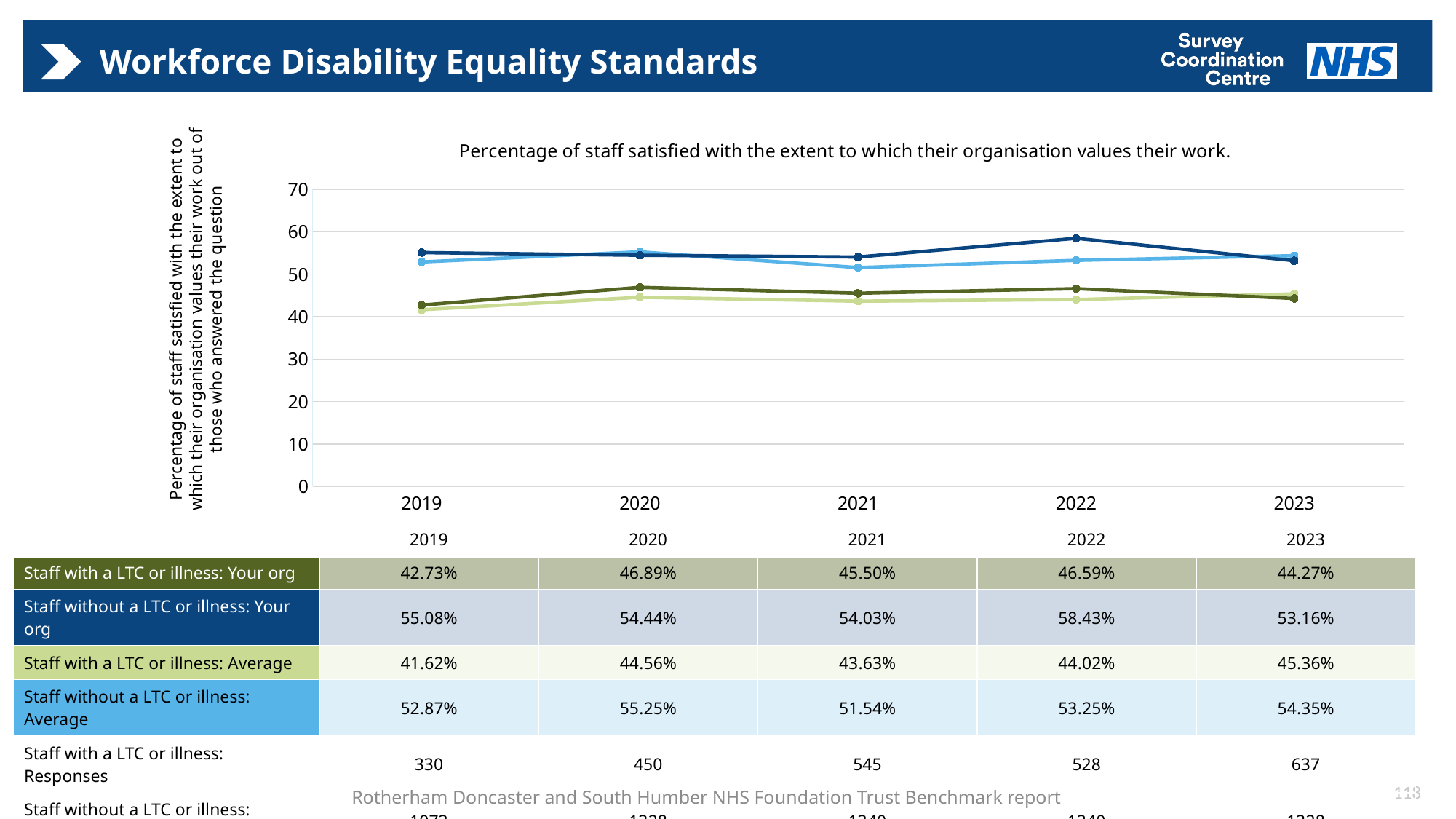
What is the value for Staff with a LTC or illness: Average in 2023? 45.36% What is the difference between Staff without a LTC or illness: Your org and Staff with a LTC or illness: Your org in 2022? 11.84% How many years are plotted on the x axis? 5 Which is larger in 2023: Staff without a LTC or illness: Average or Staff without a LTC or illness: Your org? Staff without a LTC or illness: Average How many series are plotted on the chart? 4 What is the value for Staff without a LTC or illness: Your org in 2022? 58.43% What type of chart is shown on the slide? line chart What is the value for Staff with a LTC or illness: Your org in 2020? 46.89% Is the value for Staff with a LTC or illness: Average in 2019 greater or less than 50? less What is the value for Staff without a LTC or illness: Average in 2021? 51.54% In which year is the value for Staff without a LTC or illness: Your org highest? 2022 In which year is the value for Staff with a LTC or illness: Your org lowest? 2019